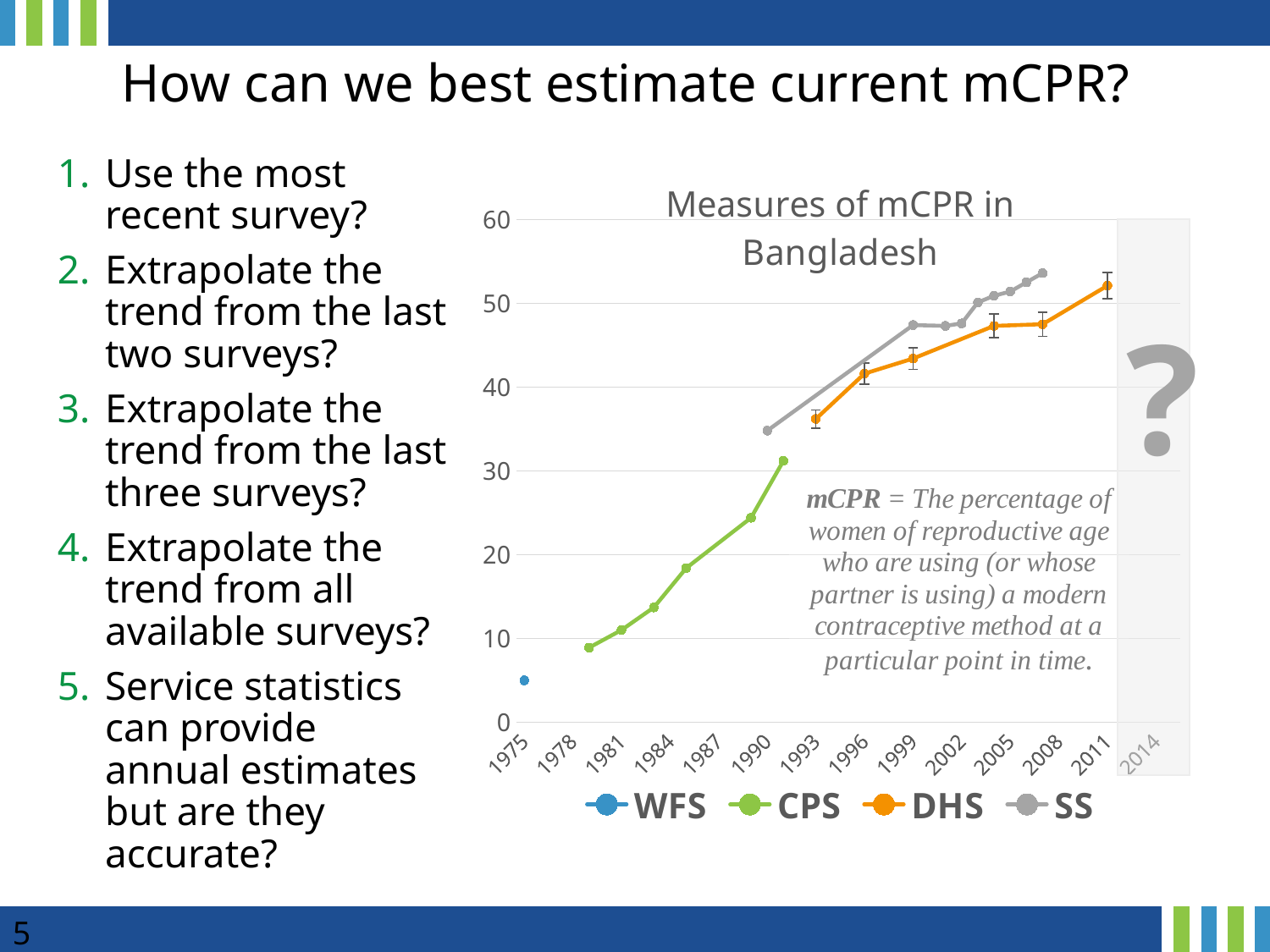
Which series is drawn in orange in the chart? DHS How many series does the legend of the chart list? 4 Is the value for SS in 1990 greater or less than 40? less Is the value for DHS in 2011 greater or less than 50? greater What kind of chart is shown on the slide? line chart Which series has the lowest plotted value in the chart? WFS Does the DHS series rise or fall over time along the x axis? rise Does the CPS series rise or fall over time along the x axis? rise What is the title of the chart? Measures of mCPR in Bangladesh Is the value for WFS in 1975 greater or less than 10? less